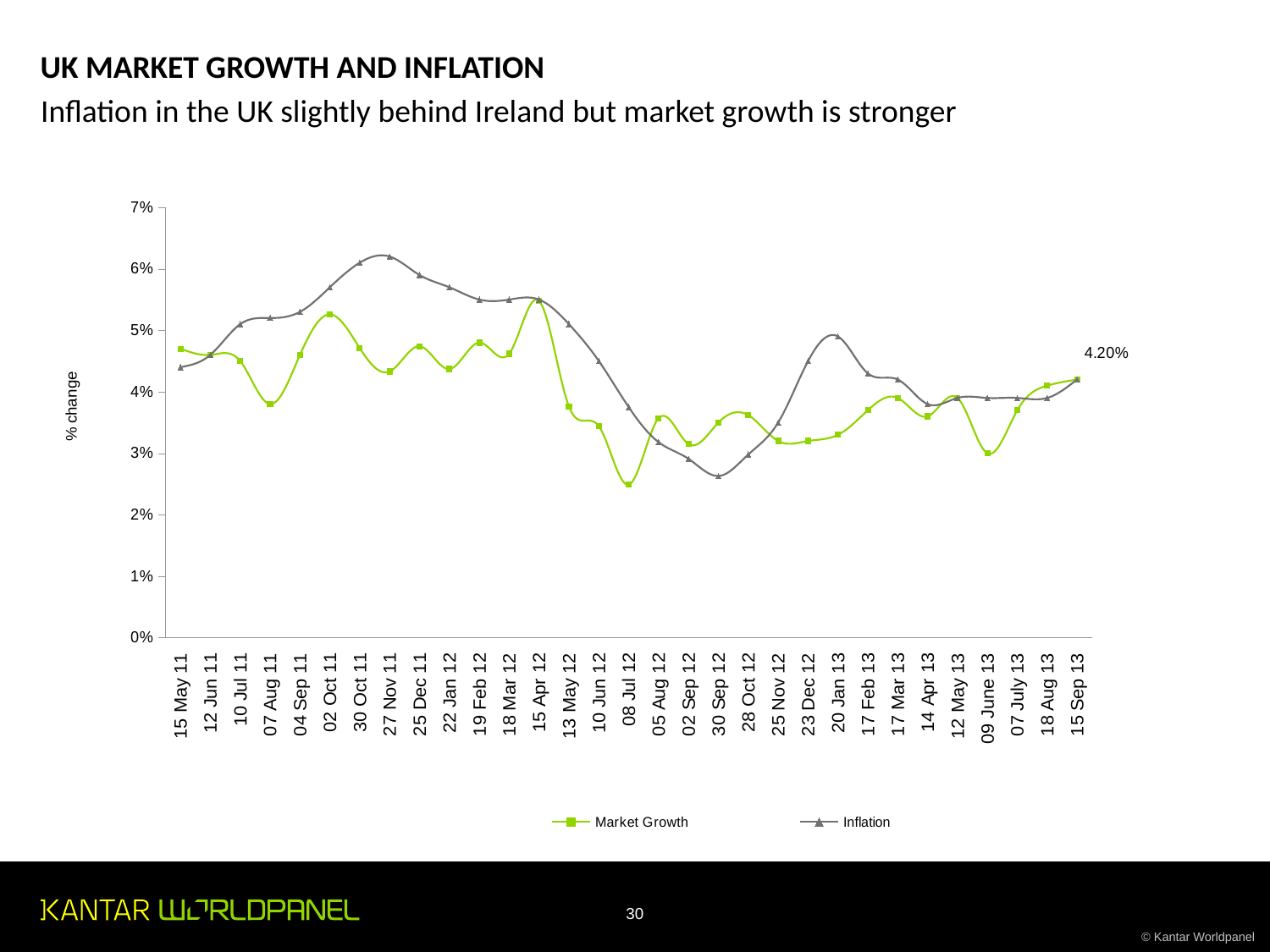
How many dates are shown on the x axis? 31 What are the two series named in the legend? Market Growth and Inflation Does the Inflation line rise or fall between 27 Nov 11 and 30 Sep 12? Fall Is the Inflation value for 30 Sep 12 greater or less than 3%? less On which date does Market Growth reach its lowest value? 08 Jul 12 At 30 Sep 12, which series is higher, Market Growth or Inflation? Market Growth How many series does the legend list? 2 What value is printed as a data label at the right end of the chart? 4.20% Is the Inflation value for 27 Nov 11 greater or less than 6%? greater At 27 Nov 11, which series is higher, Market Growth or Inflation? Inflation What kind of chart is shown on the slide? Line chart Is the Market Growth value for 08 Jul 12 greater or less than 3%? less